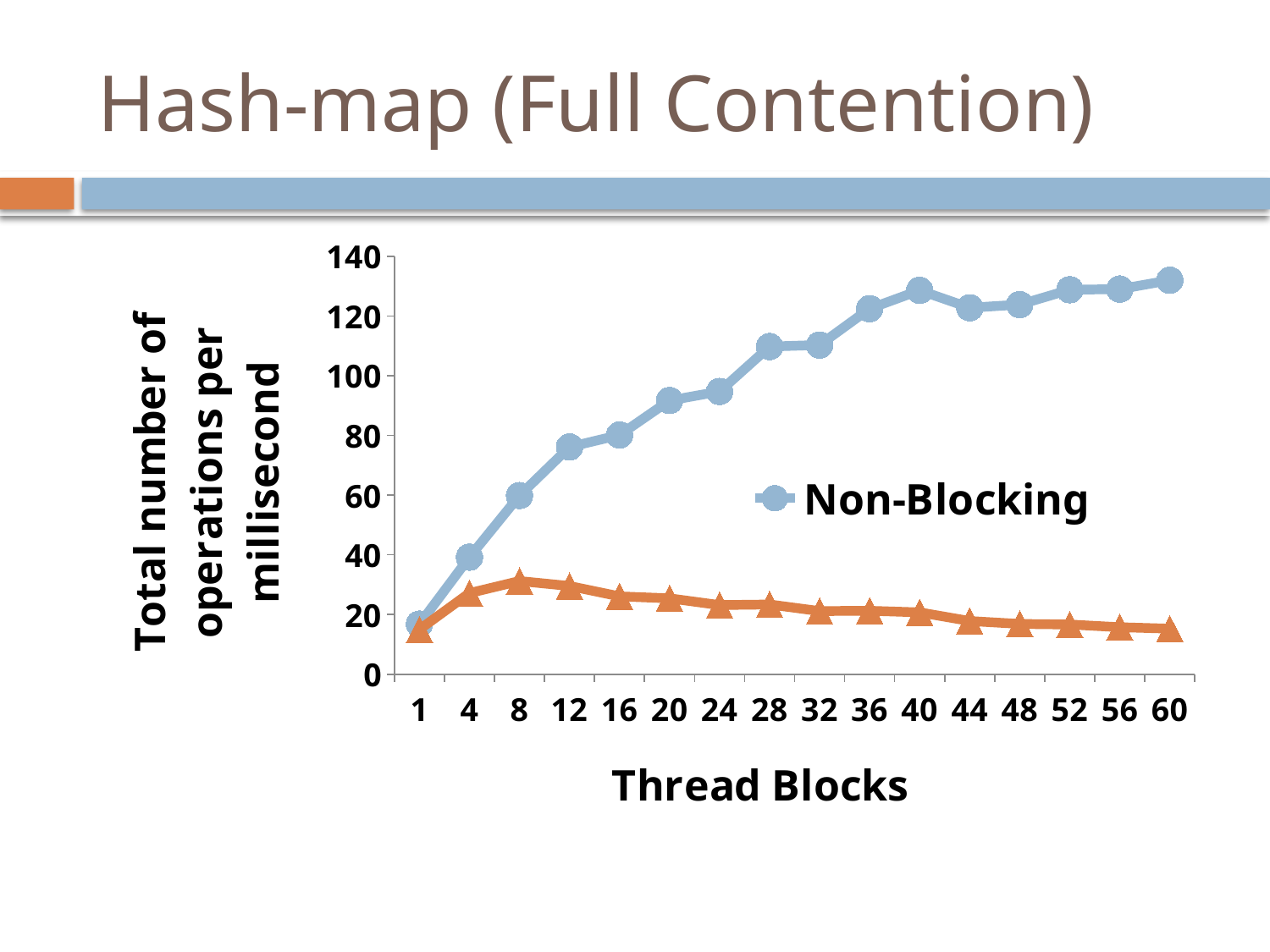
Is the Non-Blocking value at 4 thread blocks greater or less than 20? greater Is the Non-Blocking value at 8 thread blocks greater or less than 40? greater How many series does the legend list? 1 What is the title of the x axis? Thread Blocks How many thread block values are plotted along the x axis? 16 Does the Non-Blocking series generally rise or fall as the number of thread blocks increases? rise What kind of chart is shown on the slide? line chart Is the Non-Blocking value at 60 thread blocks greater or less than 120? greater At 60 thread blocks, which is larger: the Non-Blocking series or the orange triangle series? Non-Blocking